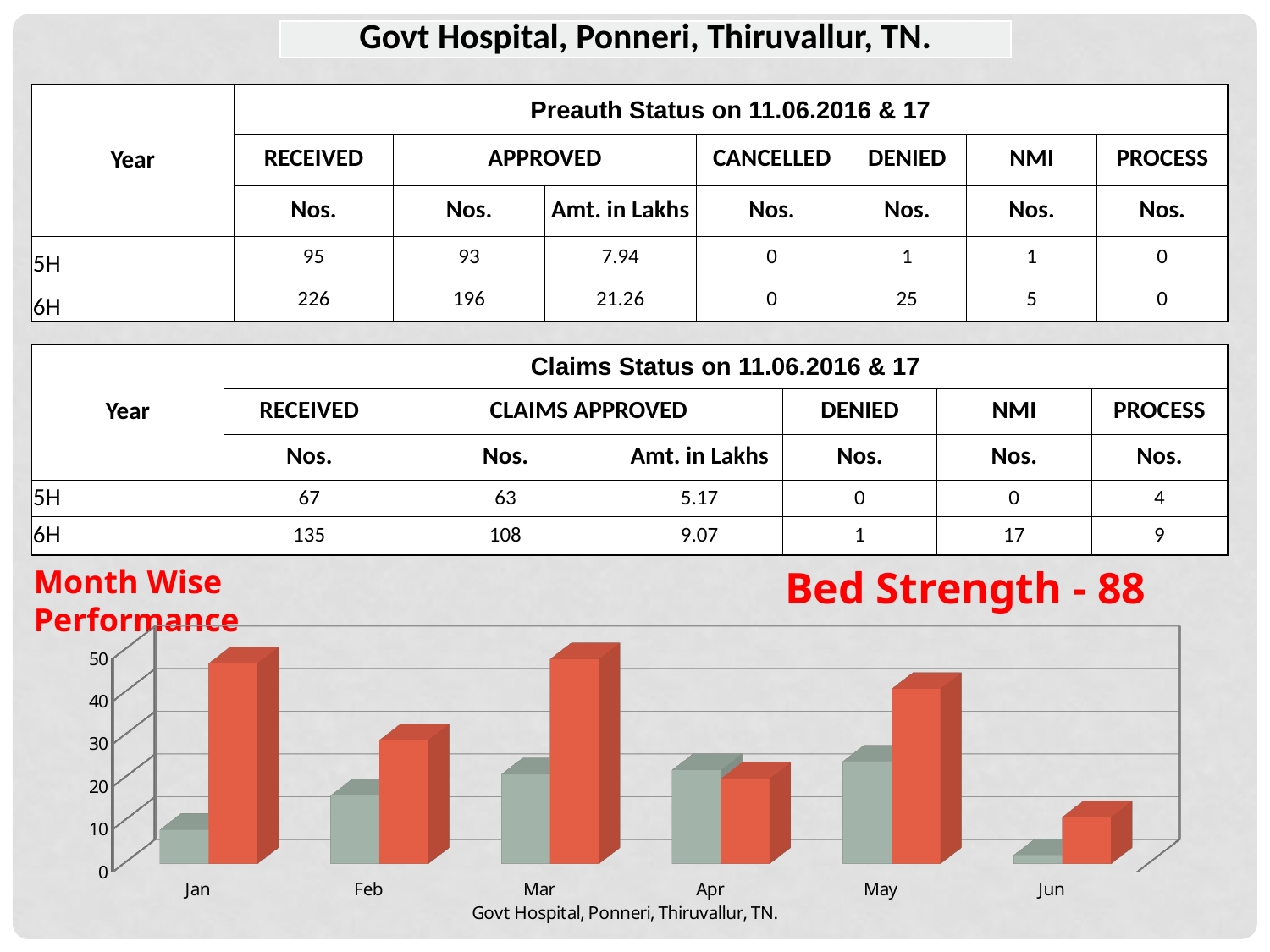
How many months are shown on the x axis of the Month Wise Performance chart? 6 What kind of chart is shown under the heading "Month Wise Performance"? bar chart In the Month Wise Performance chart, is the value of the red bar for Jun greater or less than 20? less How many bars are plotted for each month in the Month Wise Performance chart? 2 In the Month Wise Performance chart, which is larger for Jan: the red bar or the grey bar? the red bar In the Month Wise Performance chart, is the value of the red bar for Jan greater or less than 40? greater In the Month Wise Performance chart, is the value of the red bar for May greater or less than 30? greater In the Month Wise Performance chart, which month has the lowest grey bar? Jun In the Month Wise Performance chart, which month has the lowest red bar? Jun What text appears below the month labels on the x axis of the Month Wise Performance chart? Govt Hospital, Ponneri, Thiruvallur, TN.